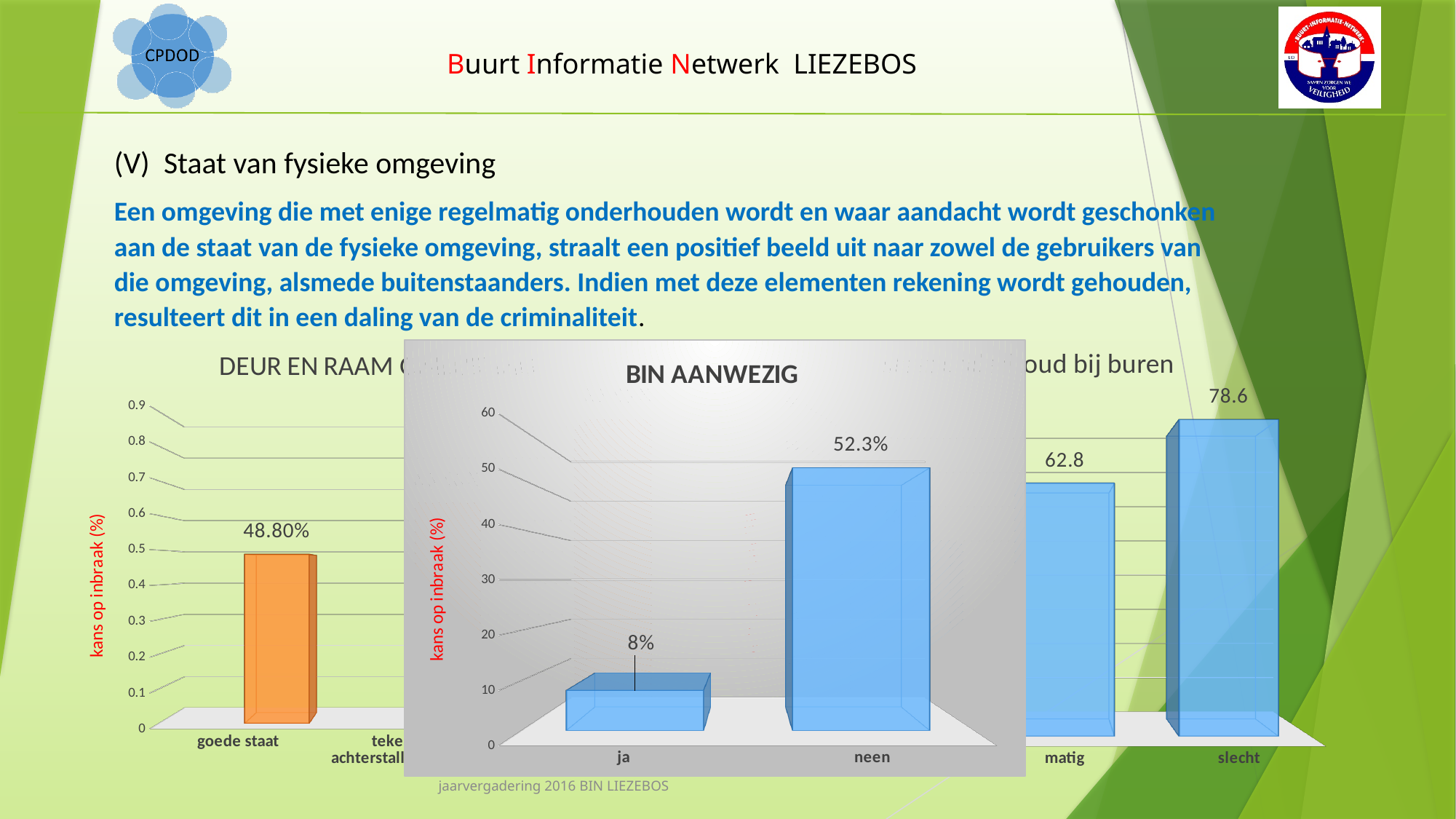
In the BIN AANWEZIG chart, what is the value for "ja"? 8% In the BIN AANWEZIG chart, what is the value for "neen"? 52.3% In the chart on the left of the slide, what is the value for "goede staat"? 48.80% In the BIN AANWEZIG chart, which category has the higher value? neen In the BIN AANWEZIG chart, what is the label on the vertical axis? kans op inbraak (%) In the BIN AANWEZIG chart, how many categories are shown on the x axis? 2 What kind of chart is the BIN AANWEZIG chart? bar chart In the chart on the right of the slide, what is the difference between the values for "slecht" and "matig"? 15.8 In the BIN AANWEZIG chart, what is the difference between the values for "neen" and "ja"? 44.3% In the chart on the right of the slide, what is the value for "slecht"? 78.6 In the BIN AANWEZIG chart, is the value for "neen" greater or less than 50? greater In the chart on the right of the slide, what is the value for "matig"? 62.8